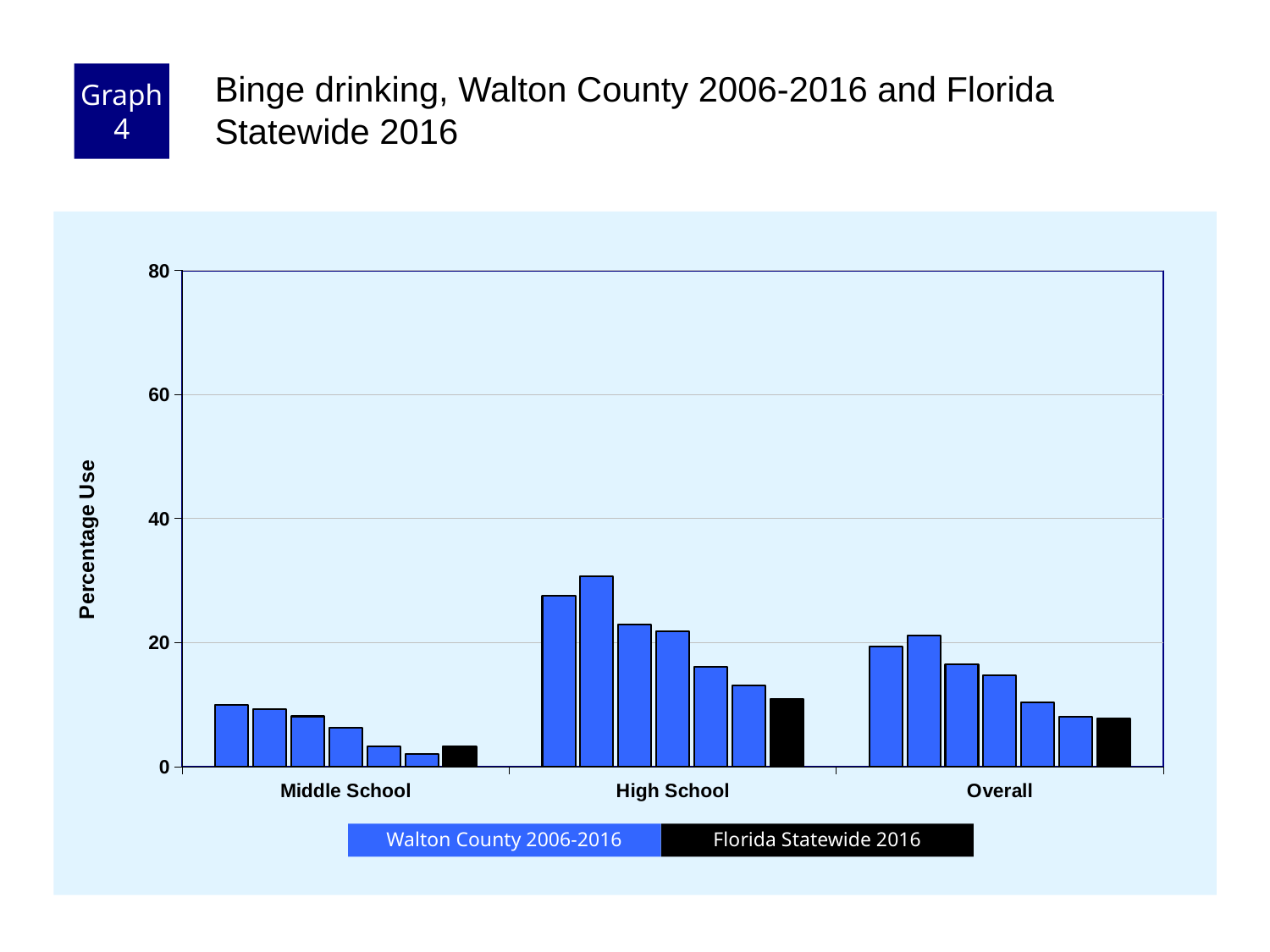
How many category groups are shown on the x axis? 3 How many series does the legend list? 2 Do the Walton County bars in the Middle School group rise or fall from left to right? fall Is the tallest Walton County bar in the High School group greater or less than 20? greater Is the tallest Walton County bar in the Overall group greater or less than 40? less Which category group has the highest bars overall? High School Which is larger, the Florida Statewide 2016 value for High School or for Middle School? High School Is the tallest Walton County bar in the Middle School group greater or less than 20? less What kind of chart is shown on the slide? Bar chart What is the label on the y axis? Percentage Use Which series is shown in black? Florida Statewide 2016